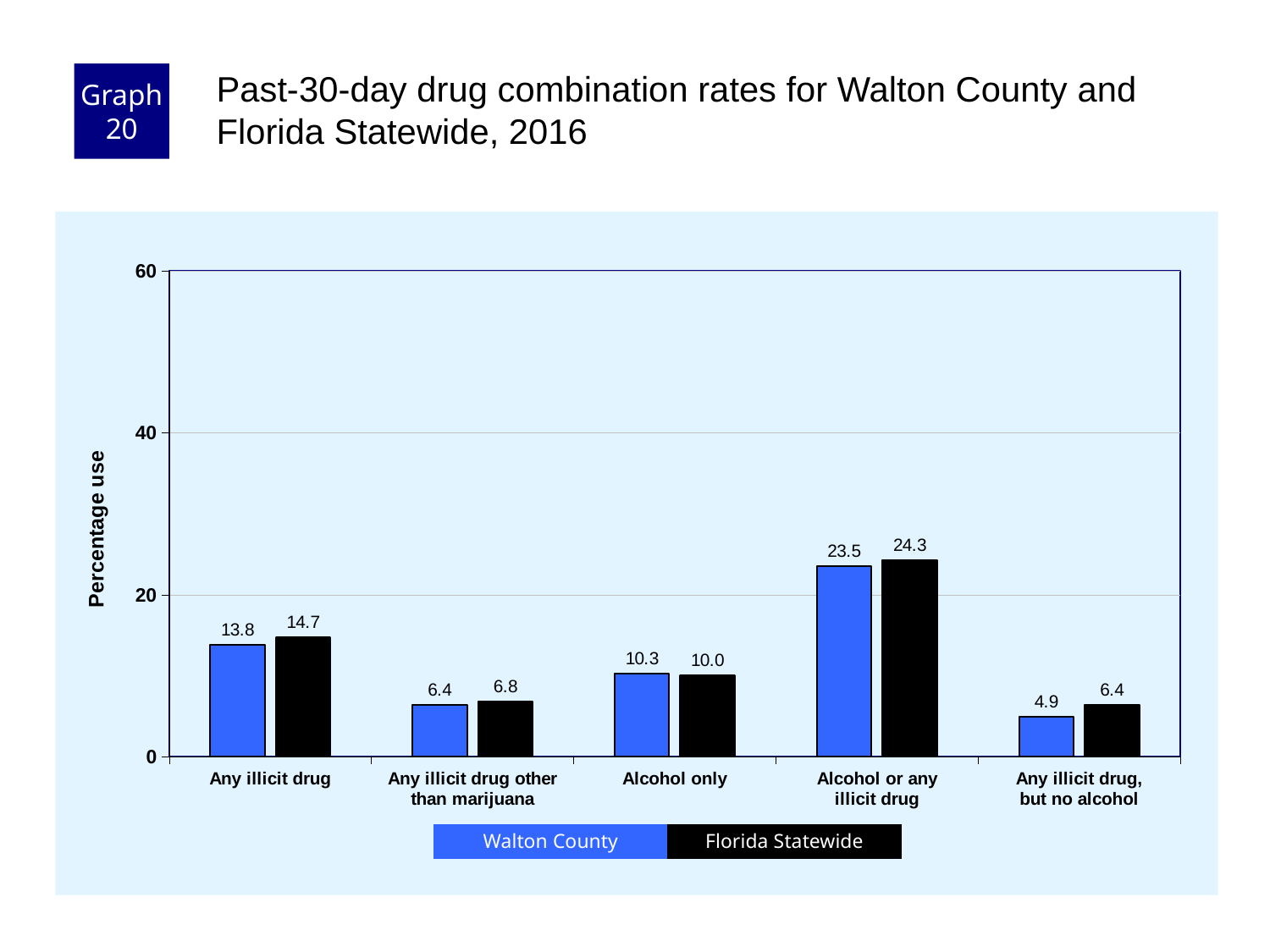
What is the Florida Statewide value for Alcohol or any illicit drug? 24.3 Which category has the highest Walton County value? Alcohol or any illicit drug What is the Walton County value for Any illicit drug? 13.8 What is the Walton County value for Any illicit drug, but no alcohol? 4.9 What kind of chart is shown on the slide? bar chart What is the difference between the Florida Statewide and Walton County values for Any illicit drug, but no alcohol? 1.5 What is the label of the y axis? Percentage use How many categories are shown on the x axis? 5 Is the Florida Statewide value for Alcohol or any illicit drug greater or less than 20? greater Which category has the lowest Florida Statewide value? Any illicit drug, but no alcohol How many series does the legend list? 2 For Alcohol only, which is larger: Walton County or Florida Statewide? Walton County